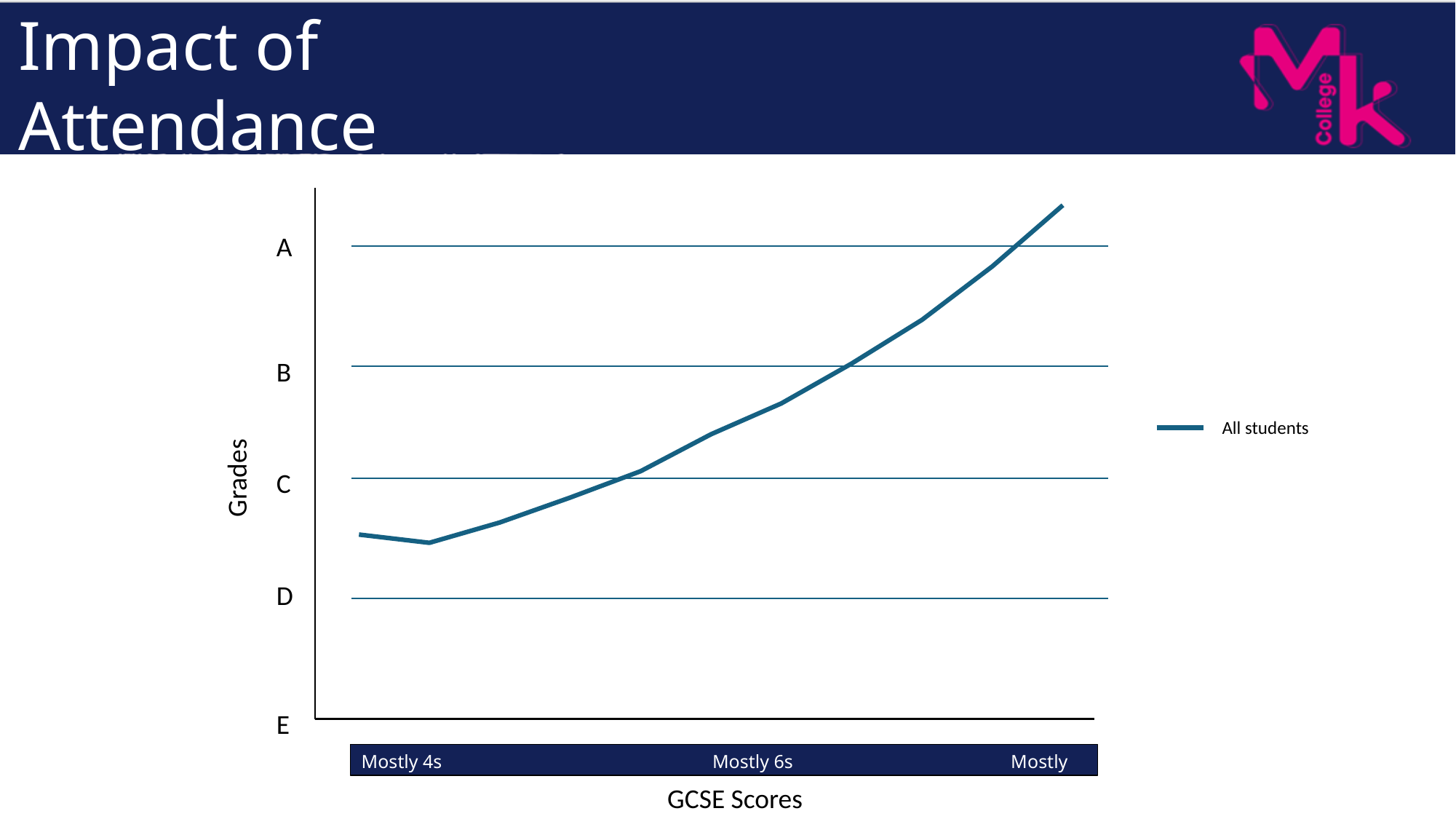
Is the grade for All students at 'Mostly 4s' above or below grade C? Below What is the highest grade label shown on the vertical axis? A Do the grades for All students generally rise or fall as GCSE scores increase along the x axis? Rise What is the label of the chart's vertical axis? Grades How many series does the chart's legend list? 1 Is the grade for All students at 'Mostly 4s' above or below grade D? Above What is the name of the series shown in the chart's legend? All students Does the All students line reach above grade A at the right-hand end of the chart? Yes Which is higher for All students: the grade at 'Mostly 4s' or the grade at 'Mostly 6s'? Mostly 6s What kind of chart is shown on the slide? Line chart